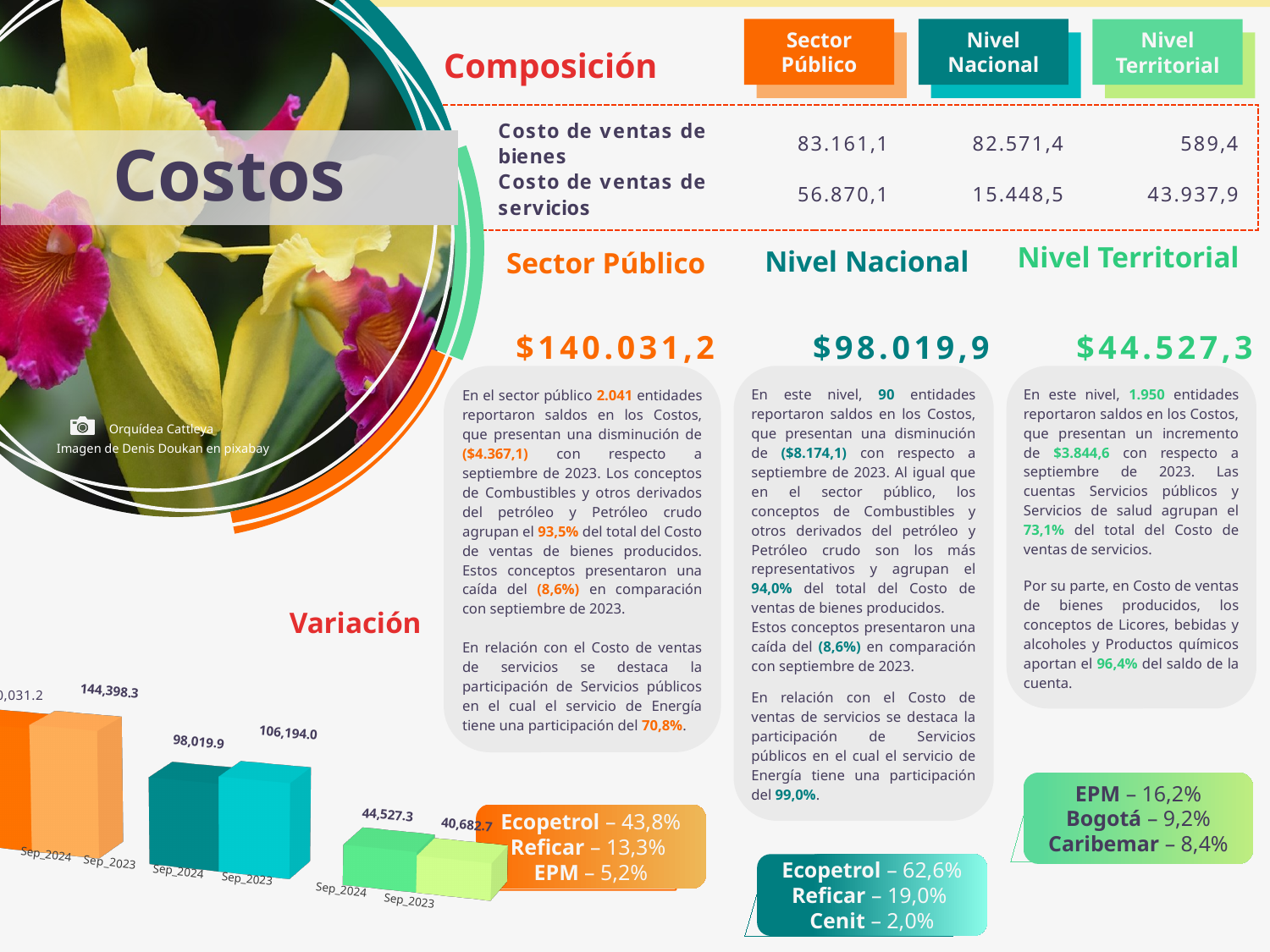
How many bars are plotted in the "Variación" chart? 6 In the "Variación" chart, what is the Sep_2024 value for the teal group of bars? 98,019.9 In the "Variación" chart, which is larger for the green group, Sep_2024 or Sep_2023? Sep_2024 In the "Variación" chart, what is the Sep_2023 value for the teal group of bars? 106,194.0 In the "Variación" chart, what is the Sep_2023 value for the green group of bars? 40,682.7 In the "Variación" chart, what is the difference between the Sep_2024 and Sep_2023 values of the green group? 3,844.6 What kind of chart is shown under the title "Variación"? bar chart In the "Variación" chart, what is the Sep_2024 value for the green group of bars? 44,527.3 In the "Variación" chart, what is the Sep_2023 value for the orange group of bars? 144,398.3 In the "Variación" chart, which bar has the lowest value? Sep_2023 in the green group (40,682.7) In the "Variación" chart, what is the difference between the Sep_2023 and Sep_2024 values of the teal group? 8,174.1 What is the title of the chart in the lower left of the slide? Variación